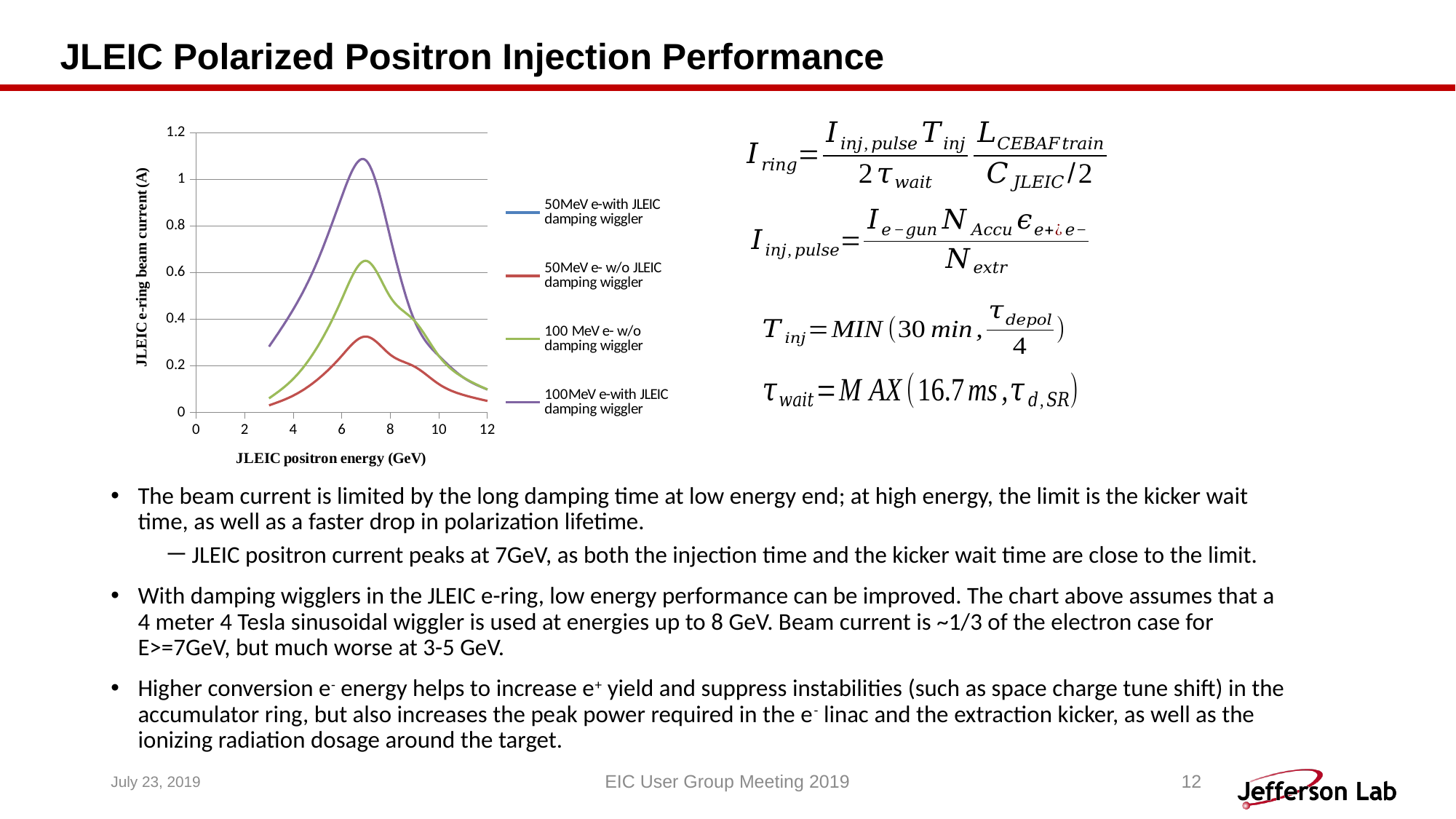
What is the title of the chart's horizontal axis? JLEIC positron energy (GeV) How many series does the chart legend list? 4 Between 4 GeV and 6 GeV, does the '100 MeV e- w/o damping wiggler' line rise or fall? rise Between 8 GeV and 12 GeV, does the '100MeV e-with JLEIC damping wiggler' line rise or fall? fall What kind of chart is shown on the slide? line chart Between which two x-axis tick values do the curves reach their peak? 6 and 8 Is the peak value of the '100 MeV e- w/o damping wiggler' line greater or less than 0.8? less Is the peak value of the '50MeV e- w/o JLEIC damping wiggler' line greater or less than 0.4? less Which series reaches the highest beam current in the chart? 100MeV e-with JLEIC damping wiggler What is the title of the chart's vertical axis? JLEIC e-ring beam current (A) Is the peak value of the '100MeV e-with JLEIC damping wiggler' line greater or less than 1? greater Near 7 GeV, which line is higher: '100MeV e-with JLEIC damping wiggler' or '100 MeV e- w/o damping wiggler'? 100MeV e-with JLEIC damping wiggler